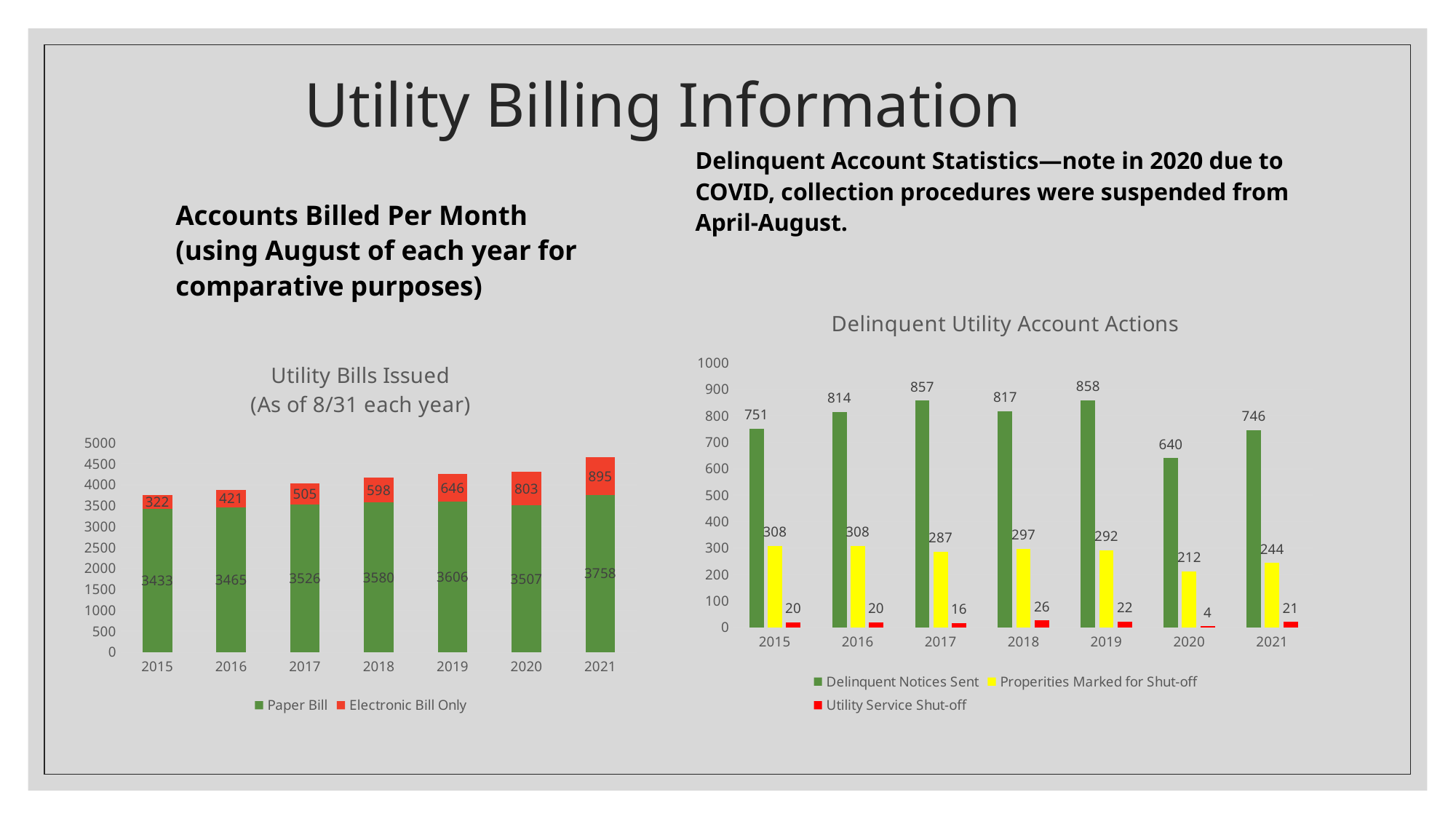
In the 'Delinquent Utility Account Actions' chart, what is the difference between Properties Marked for Shut-off in 2015 and 2020? 96 In the 'Utility Bills Issued' chart, what is the difference between the Paper Bill values for 2021 and 2020? 251 What type of chart is the 'Delinquent Utility Account Actions' chart? Bar chart In the 'Delinquent Utility Account Actions' chart, which year has the lowest Utility Service Shut-off value? 2020 In the 'Utility Bills Issued' chart, what is the total of the stacked bar for 2015? 3755 In the 'Utility Bills Issued' chart, what is the Paper Bill value for 2019? 3606 In the 'Delinquent Utility Account Actions' chart, how many Delinquent Notices were sent in 2017? 857 In the 'Utility Bills Issued' chart, what is the Electronic Bill Only value for 2021? 895 In the 'Delinquent Utility Account Actions' chart, which year has the highest Delinquent Notices Sent value? 2019 In the 'Utility Bills Issued' chart, which year has the lowest Electronic Bill Only value? 2015 In the 'Utility Bills Issued' chart, how many series does the legend list? 2 In the 'Delinquent Utility Account Actions' chart, how many years are shown on the x axis? 7